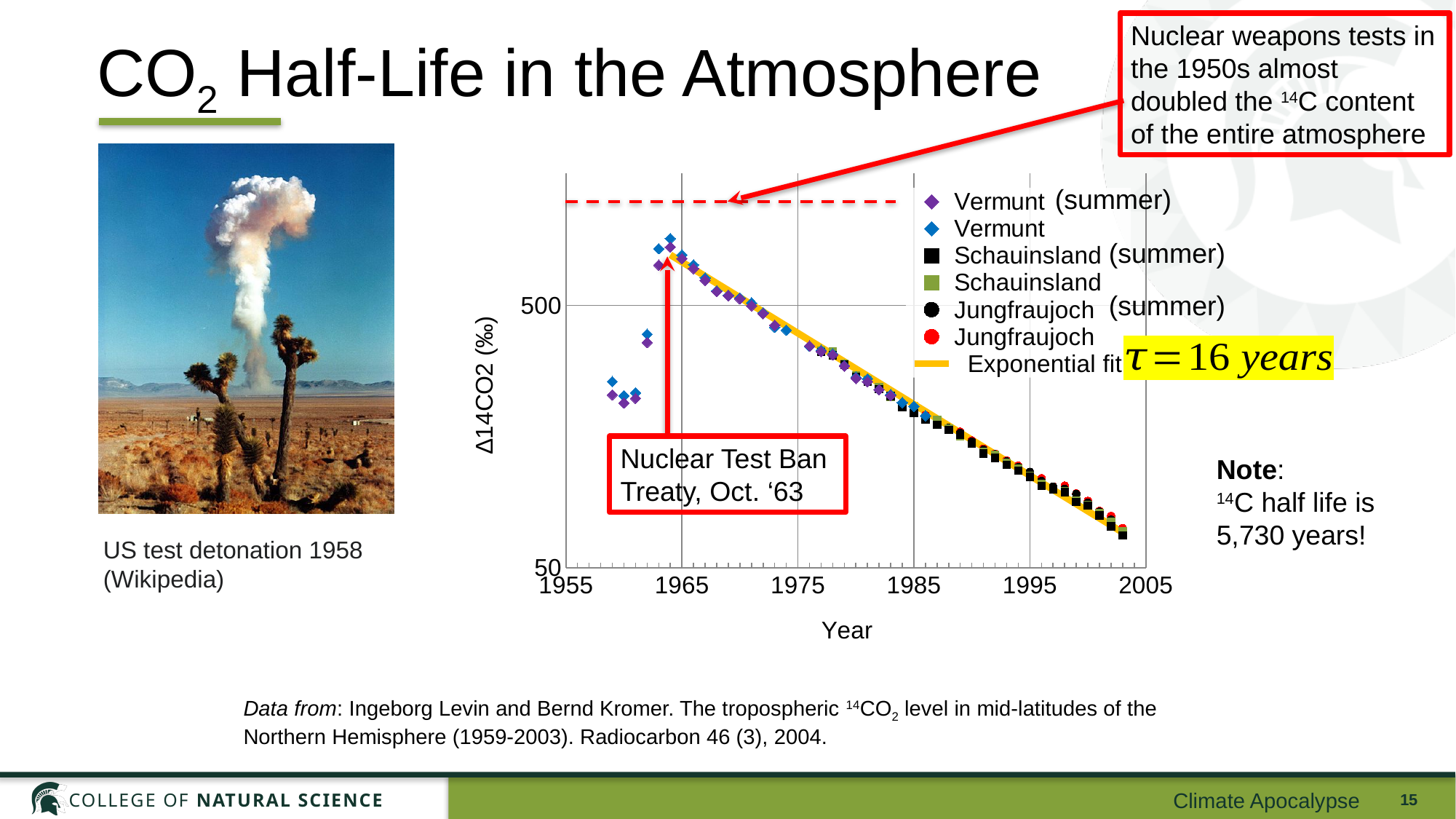
How many entries does the chart's legend list? 7 What is the label of the chart's x axis? Year Is the value of the Vermunt series around 1959 greater or less than 500? less What is the first year shown on the chart's x axis? 1955 What is the last year shown on the chart's x axis? 2005 What kind of chart is shown on the slide? Scatter chart What is the label of the chart's y axis? Δ14CO2 (‰) Which is larger: the Vermunt value around 1964 or the Schauinsland value around 2003? Vermunt value around 1964 What time constant is given for the exponential fit on the chart? τ = 16 years Do the plotted values rise or fall along the x axis after 1965? Fall Is the peak value of the Vermunt series around 1964 greater or less than 500? greater Is the value of the Schauinsland series around 2003 greater or less than 500? less